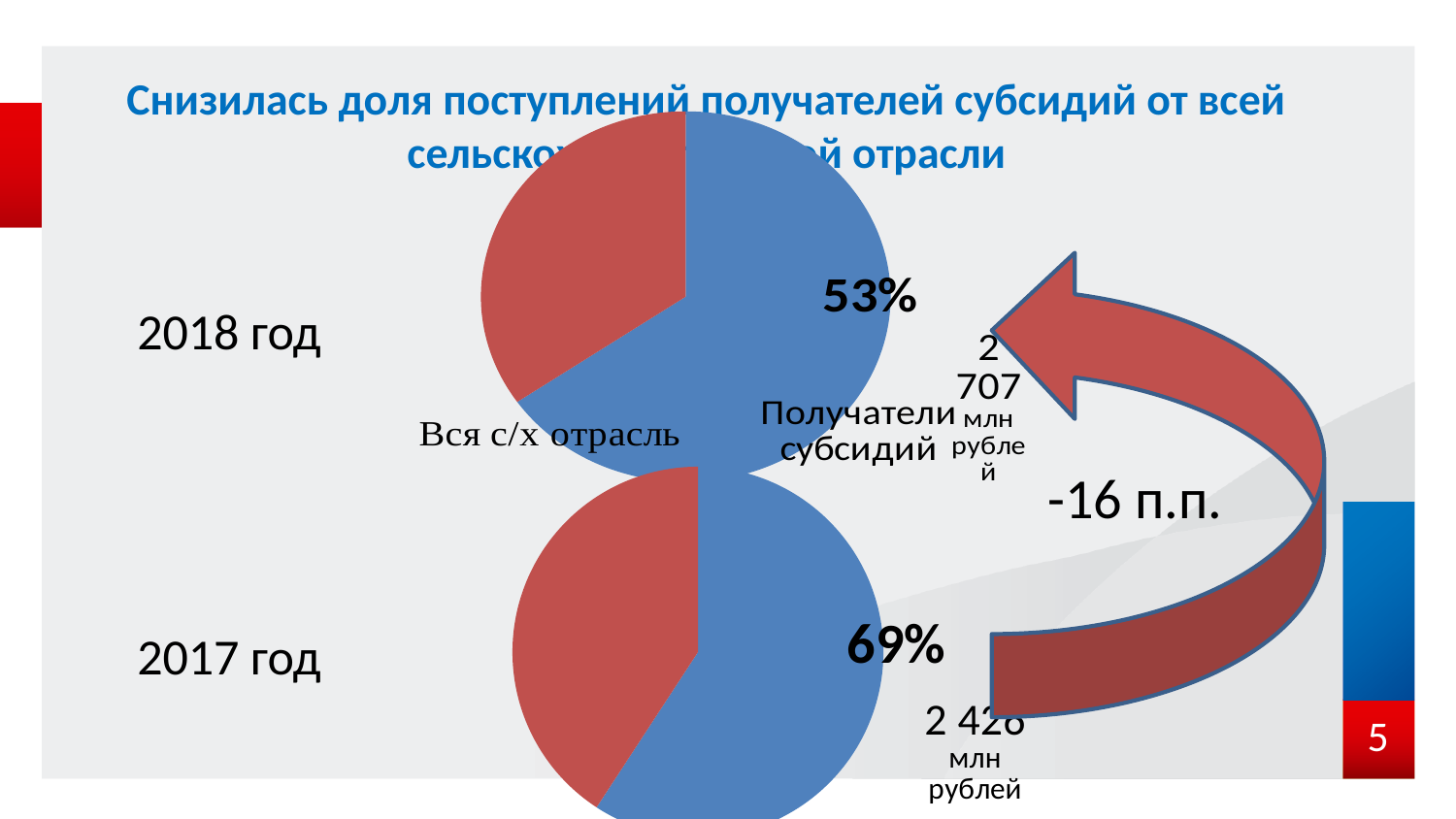
How many slices does the 2017 год pie chart have? 2 What amount in млн рублей is printed next to the 2018 год pie chart? 2 707 млн рублей What change in percentage points is shown by the arrow between the 2017 год and 2018 год pie charts? -16 п.п. Which year's pie chart shows the larger share for Получатели субсидий, 2018 год or 2017 год? 2017 год What kind of chart is used to show the 2018 год data? pie chart By how many percentage points does the Получатели субсидий share in the 2017 год pie exceed that in the 2018 год pie? 16 In the 2017 год pie chart, what share is labelled for Получатели субсидий? 69% In the 2018 год pie chart, what share is labelled for Получатели субсидий? 53% In the 2018 год pie chart, what colour is the Получатели субсидий slice? blue Is the Получатели субсидий share in the 2017 год pie chart greater or less than 50%? greater How many slices does the 2018 год pie chart have? 2 In the 2018 год pie chart, what is the label of the red slice? Вся с/х отрасль